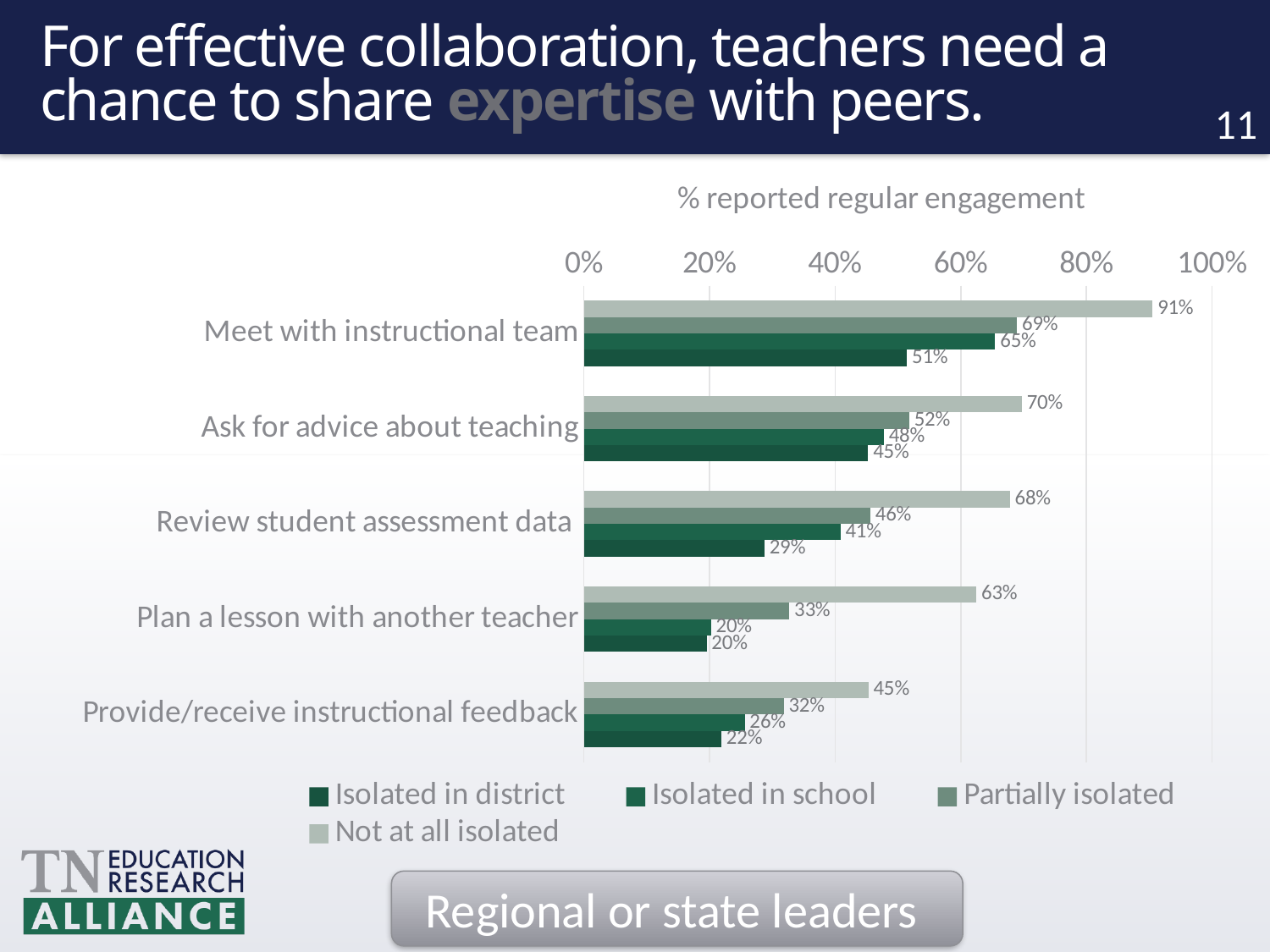
What is the value for 'Partially isolated' for 'Plan a lesson with another teacher'? 33% How many series does the legend list? 4 Which activity has the lowest value for the 'Not at all isolated' series? Provide/receive instructional feedback Which activity has the highest value for the 'Not at all isolated' series? Meet with instructional team What is the difference between the 'Not at all isolated' and 'Isolated in district' values for 'Meet with instructional team'? 40% What percentage of 'Not at all isolated' leaders reported regular engagement in 'Meet with instructional team'? 91% What is the value for 'Isolated in district' for 'Review student assessment data'? 29% How many categories (activities) are shown on the chart? 5 What is the difference between the 'Not at all isolated' and 'Partially isolated' values for 'Plan a lesson with another teacher'? 30% For 'Ask for advice about teaching', which is larger: the 'Not at all isolated' value or the 'Partially isolated' value? Not at all isolated What is the title shown above the chart's axis? % reported regular engagement What kind of chart is shown on the slide? bar chart